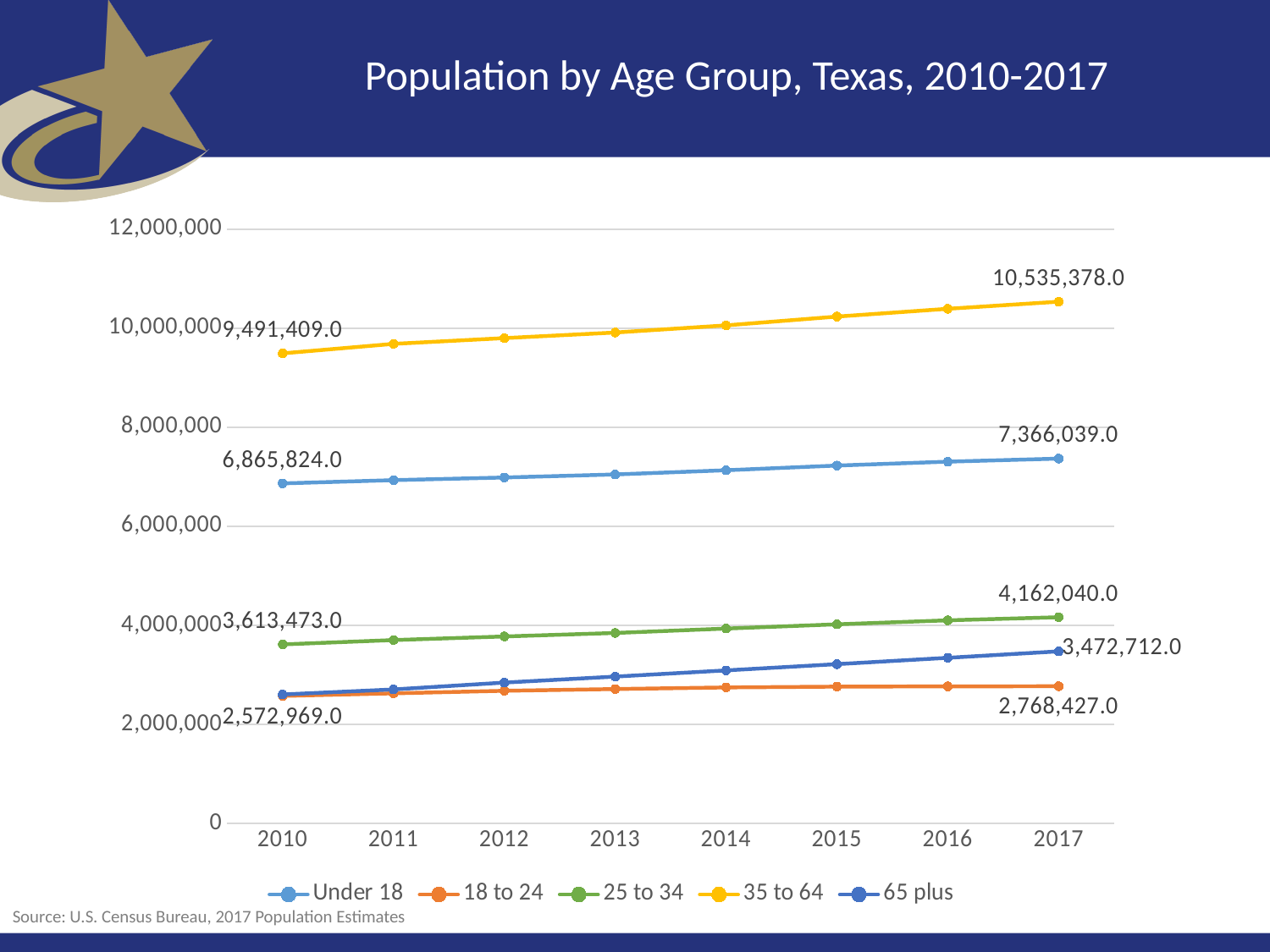
What kind of chart is shown on the slide? line chart What is the value for the 35 to 64 age group in 2017? 10,535,378.0 What is the value for the Under 18 age group in 2010? 6,865,824.0 Which age group has the lowest population in 2017? 18 to 24 What is the value for the 65 plus age group in 2017? 3,472,712.0 How many years are plotted along the x axis? 8 What is the value for the 25 to 34 age group in 2017? 4,162,040.0 Which age group has the highest population in 2017? 35 to 64 How many series does the legend list? 5 By how much did the 35 to 64 population grow from 2010 to 2017? 1,043,969.0 Which is larger in 2017, the 25 to 34 group or the 65 plus group? 25 to 34 Is the value for Under 18 in 2014 greater or less than 8,000,000? less